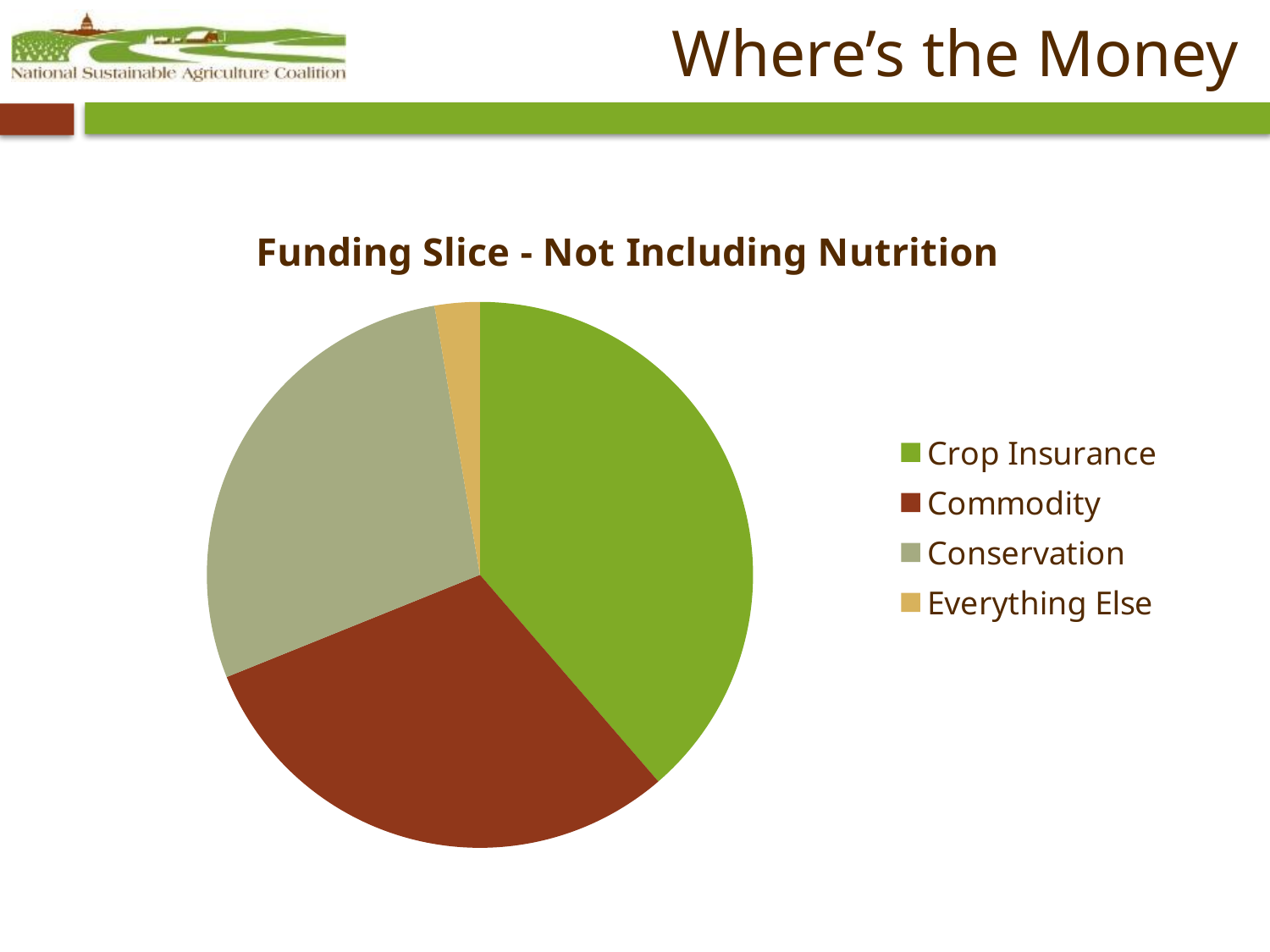
Which slice is larger, Commodity or Everything Else? Commodity Which category has the largest slice of the pie? Crop Insurance Which slice is larger, Conservation or Everything Else? Conservation What is the title of the chart? Funding Slice - Not Including Nutrition Which category is shown in the dark red-brown colour? Commodity How many entries does the legend list? 4 What kind of chart is shown on the slide? Pie chart Which slice is larger, Crop Insurance or Commodity? Crop Insurance How many slices does the pie chart have? 4 Which category has the smallest slice of the pie? Everything Else